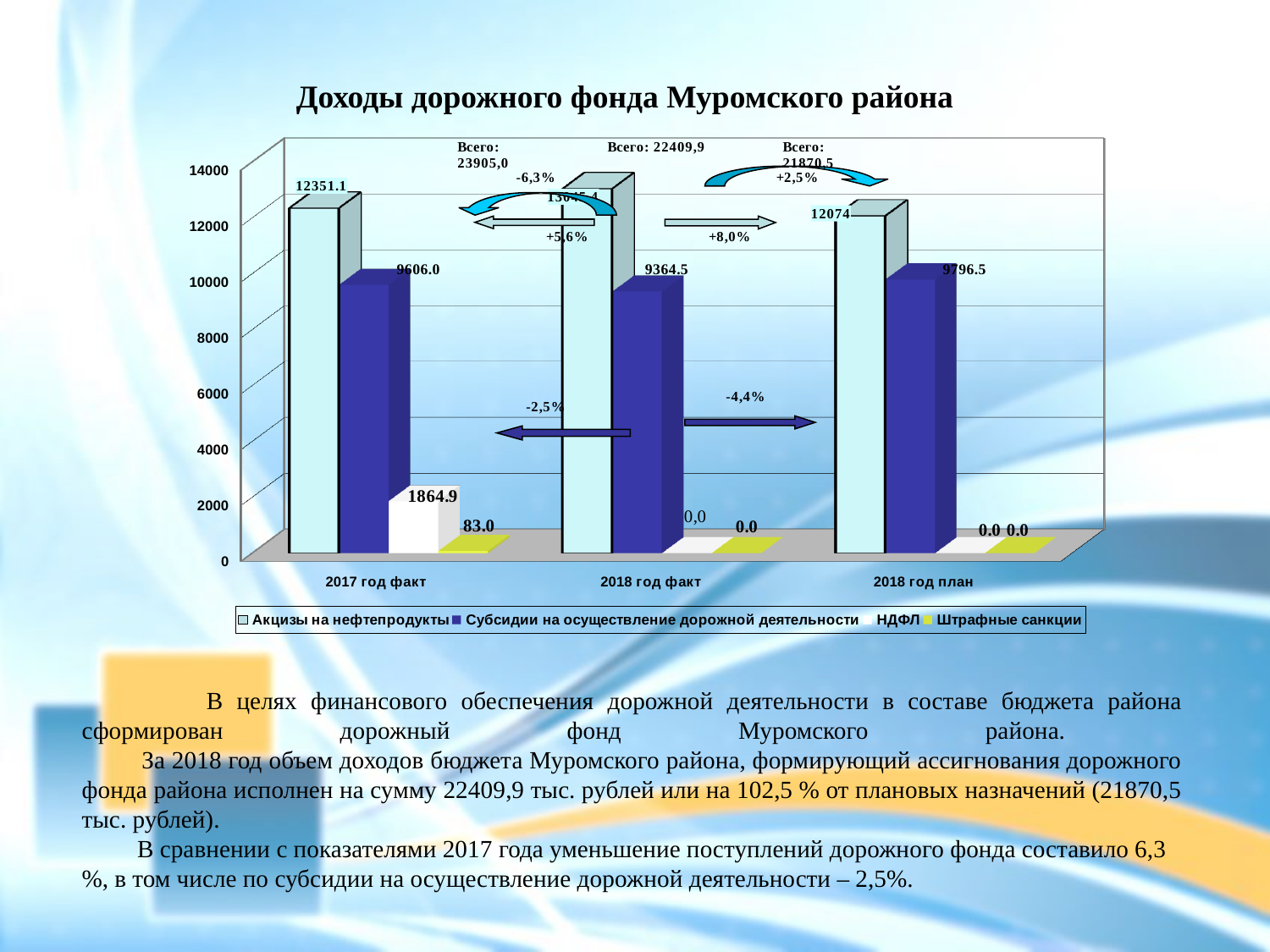
How many series does the legend list? 4 Is the value of Акцизы на нефтепродукты for 2018 год план greater or less than 12000? greater What is the value of Акцизы на нефтепродукты for 2018 год план? 12074 What is the title of the chart? Доходы дорожного фонда Муромского района What is the value of Штрафные санкции for 2017 год факт? 83.0 Which category has the highest value for Субсидии на осуществление дорожной деятельности? 2018 год план What type of chart is shown on the slide? bar chart What is the value of Акцизы на нефтепродукты for 2017 год факт? 12351.1 What is the value of Субсидии на осуществление дорожной деятельности for 2018 год факт? 9364.5 How many categories are shown on the x axis? 3 What is the difference between Субсидии на осуществление дорожной деятельности for 2018 год план and 2018 год факт? 432.0 What is the value of НДФЛ for 2017 год факт? 1864.9